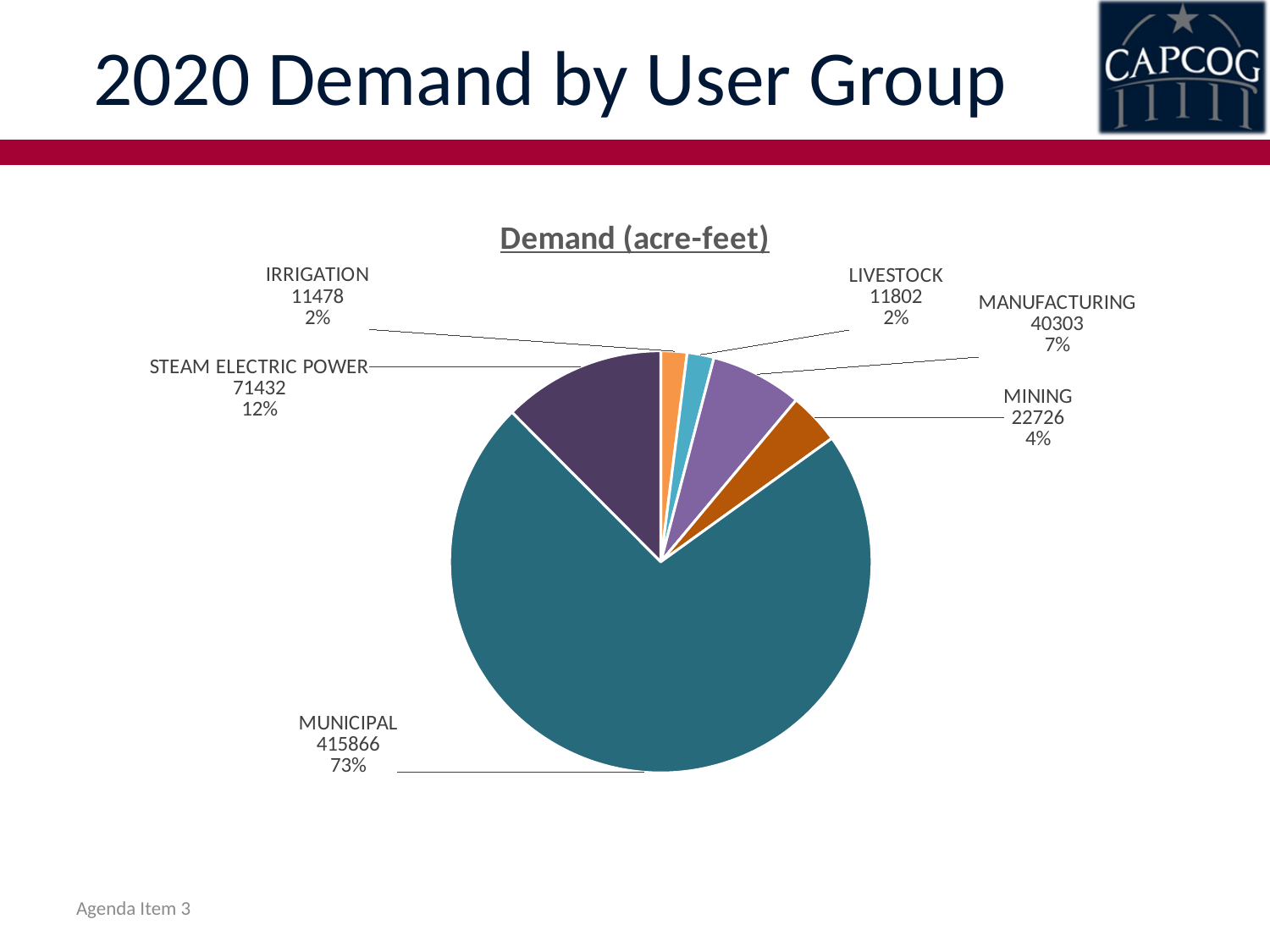
What is the demand value for MUNICIPAL? 415866 Which user group has the lowest demand? IRRIGATION What share of the pie does STEAM ELECTRIC POWER represent? 12% What is the difference in demand between MUNICIPAL and STEAM ELECTRIC POWER? 344434 How many user groups are shown in the pie chart? 6 Which user group has the highest demand? MUNICIPAL What is the demand value for MINING? 22726 What share of the pie does MUNICIPAL represent? 73% What type of chart is shown on the slide? Pie chart What is the demand value for MANUFACTURING? 40303 What is the demand value for STEAM ELECTRIC POWER? 71432 Which has a larger demand, MANUFACTURING or MINING? MANUFACTURING